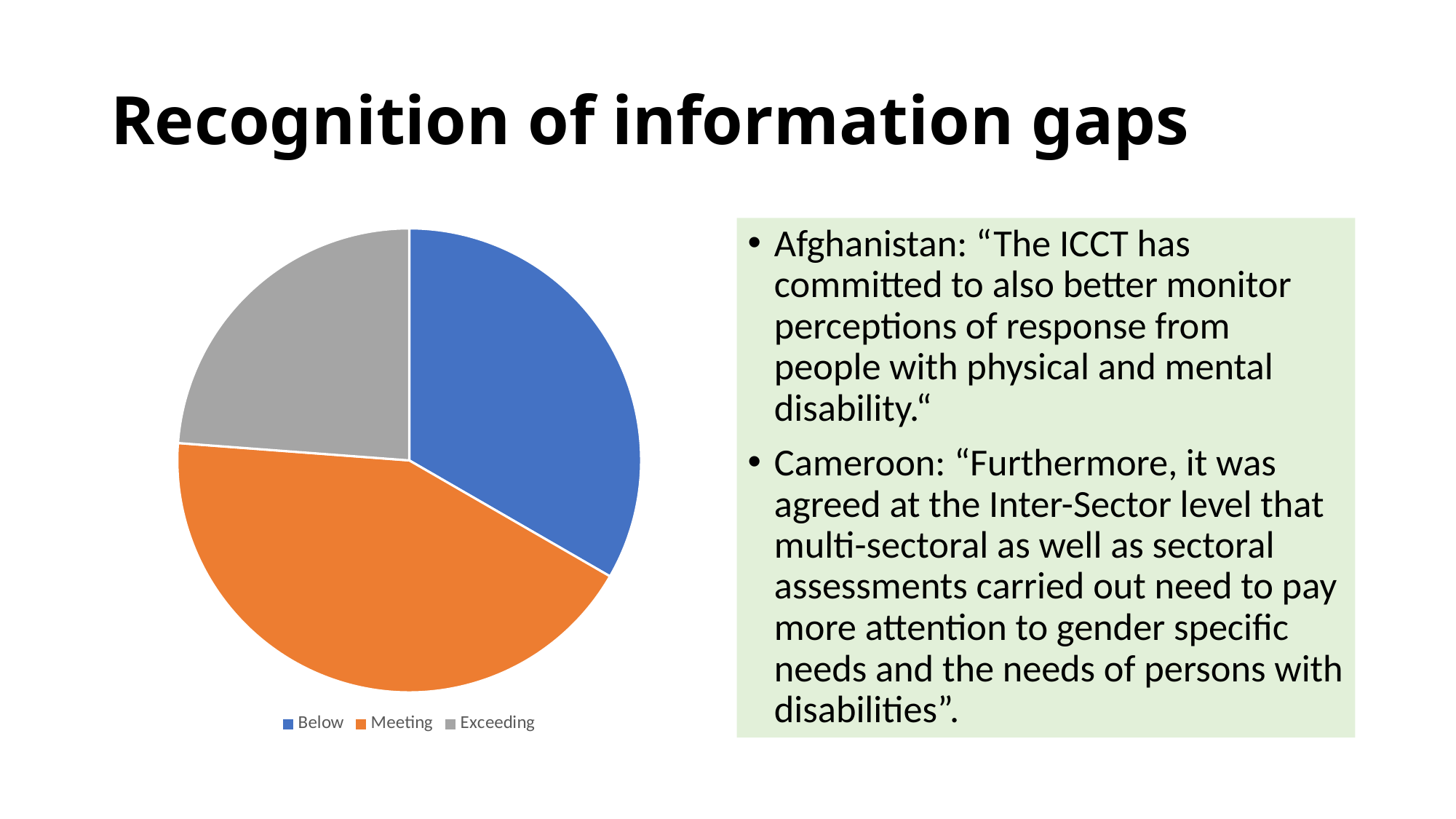
Which slice is larger in the pie chart, Below or Exceeding? Below Which category has the smallest slice of the pie chart? Exceeding Which slice is larger in the pie chart, Meeting or Below? Meeting Which category is shown in blue in the pie chart? Below Which category has the largest slice of the pie chart? Meeting What kind of chart is shown on the slide? Pie chart What colour is the Meeting slice in the pie chart? Orange Which slice is larger in the pie chart, Meeting or Exceeding? Meeting How many slices does the pie chart have? 3 How many entries does the legend of the pie chart list? 3